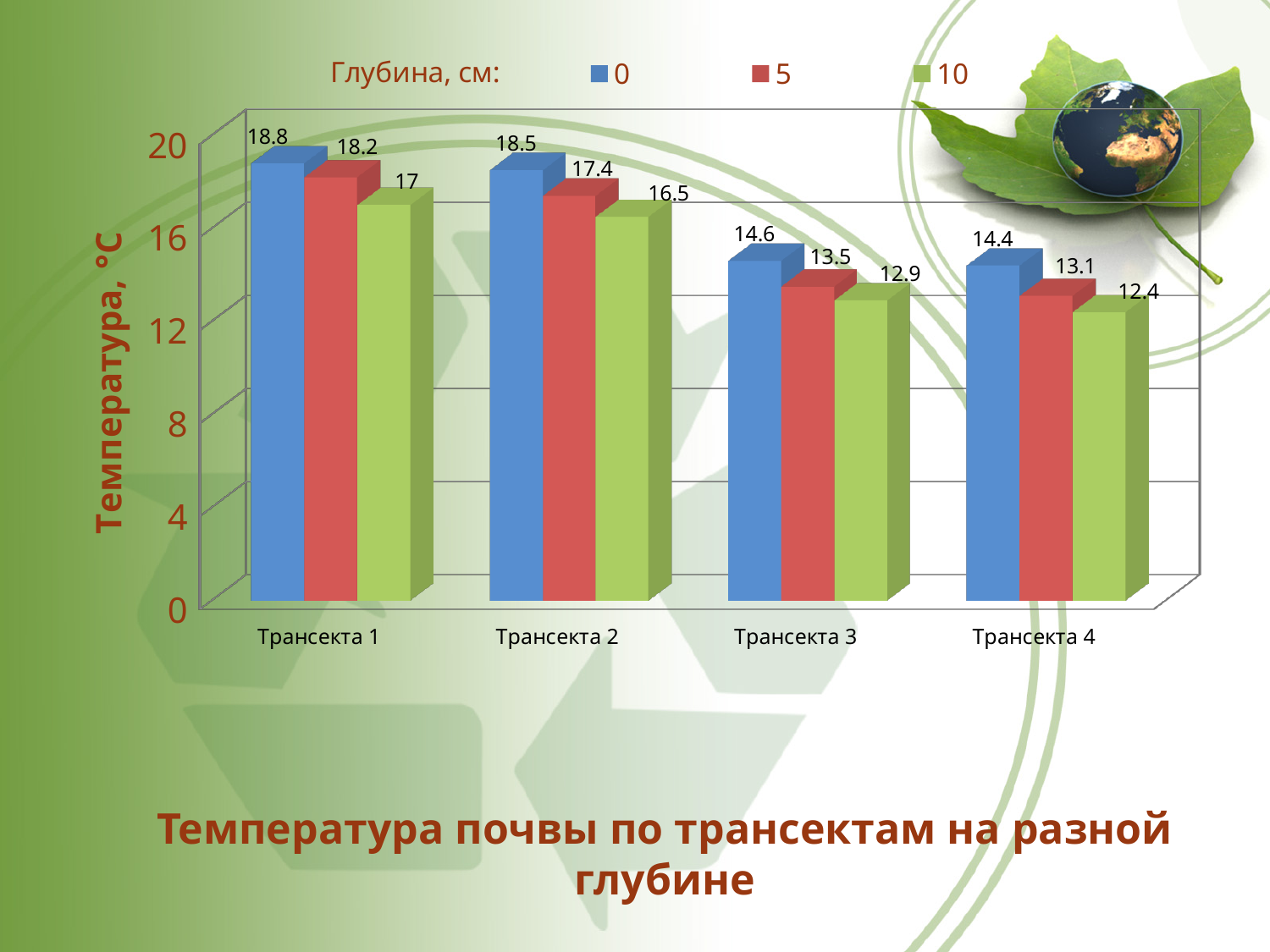
What kind of chart is shown on the slide? bar chart What is the temperature for Трансекта 1 at depth 0 cm? 18.8 Which is larger: the temperature for Трансекта 2 at depth 5 cm or for Трансекта 3 at depth 0 cm? Трансекта 2 at depth 5 cm What is the temperature for Трансекта 3 at depth 5 cm? 13.5 Which transect has the lowest temperature at depth 10 cm? Трансекта 4 How many series does the legend list? 3 Which transect has the highest temperature at depth 0 cm? Трансекта 1 What is the title of the chart? Температура почвы по трансектам на разной глубине Is the temperature for Трансекта 3 at depth 10 cm greater or less than 16? less What is the difference between the temperature at depth 0 cm and at depth 10 cm for Трансекта 2? 2 How many transects are shown on the x axis? 4 What is the temperature for Трансекта 4 at depth 10 cm? 12.4